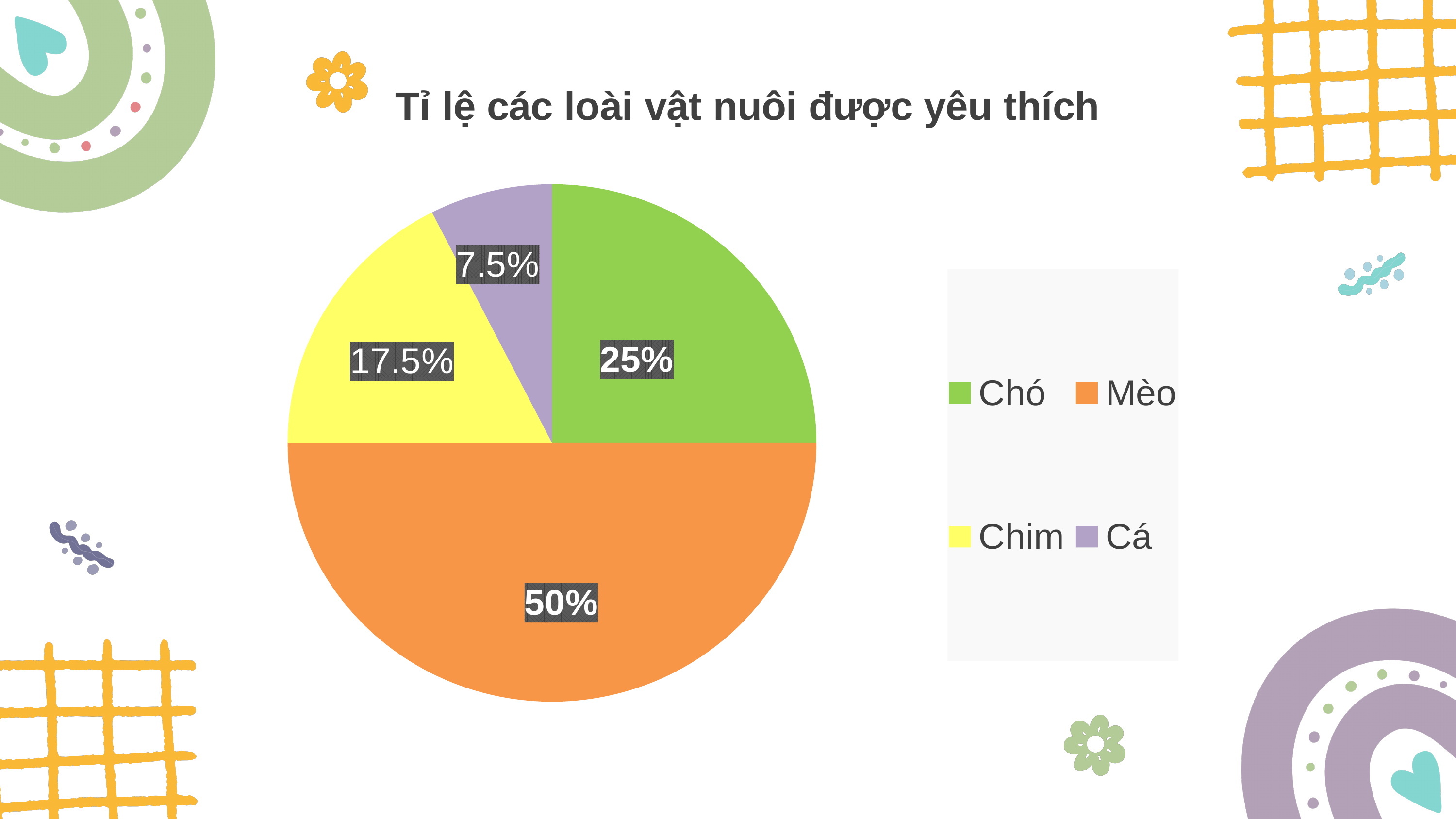
What kind of chart is shown on the slide? pie chart What is the difference between the values for Mèo and Chó? 25% What is the difference between the values for Chim and Cá? 10% What is the value for Chim? 17.5% Which is larger, the value for Chó or the value for Chim? Chó What is the value for Mèo? 50% What is the title of the chart? Tỉ lệ các loài vật nuôi được yêu thích What is the value for Cá? 7.5% Which category has the smallest share of the pie? Cá Which category has the largest share of the pie? Mèo What is the value for Chó? 25% How many slices does the pie chart have? 4